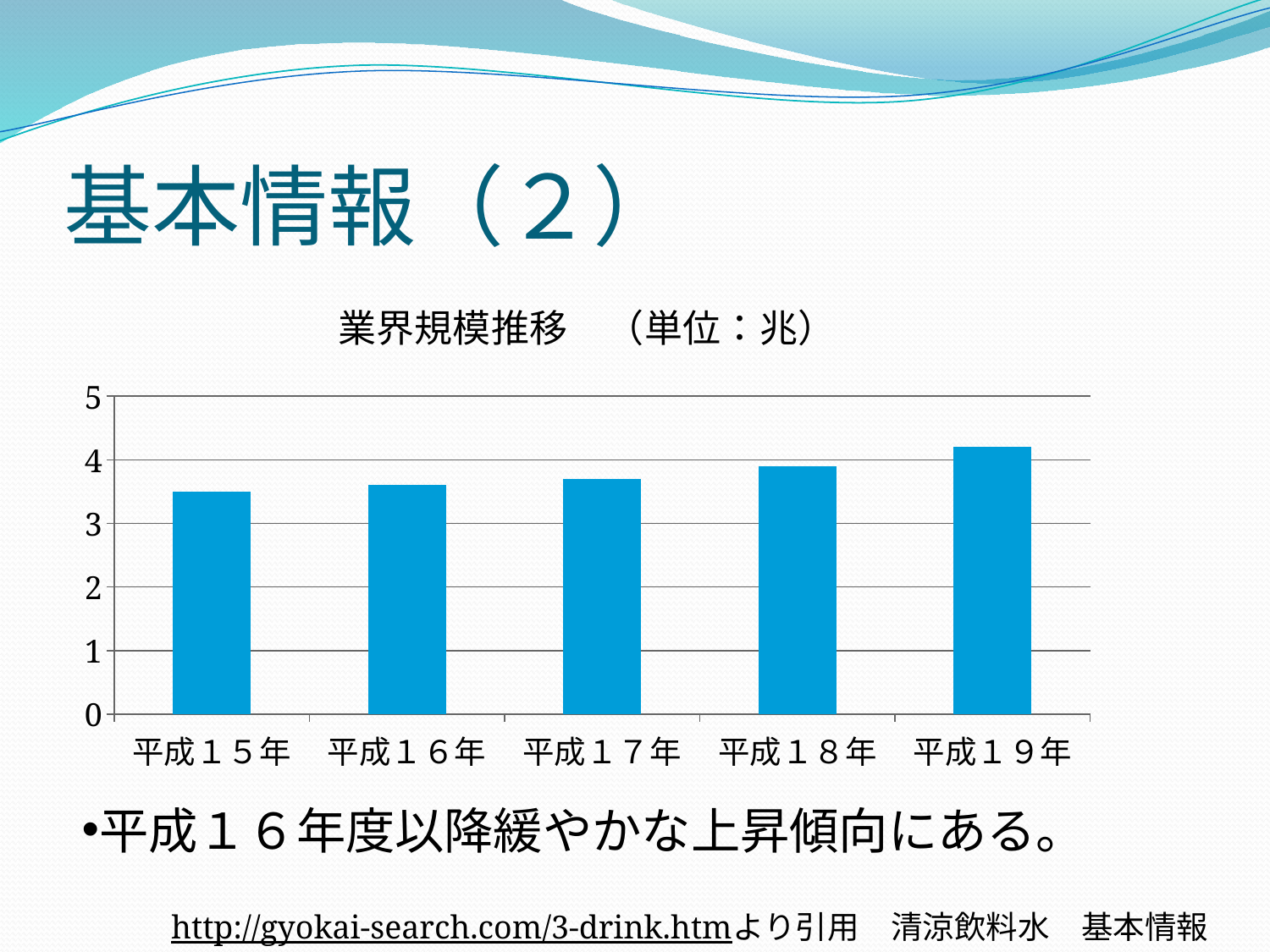
Do the values rise or fall from 平成１５年 to 平成１９年? rise Is the value for 平成１９年 greater or less than 4? greater What is the title of the chart? 業界規模推移 （単位：兆） Is the value for 平成１７年 greater or less than 4? less Is the value for 平成１５年 greater or less than 4? less What kind of chart is shown on the slide? bar chart How many years (categories) are plotted on the chart? 5 What unit is stated in the chart title? 兆 Which year has the lowest bar on the chart? 平成１５年 Which year has the highest bar on the chart? 平成１９年 Which is larger, the value for 平成１９年 or the value for 平成１５年? 平成１９年